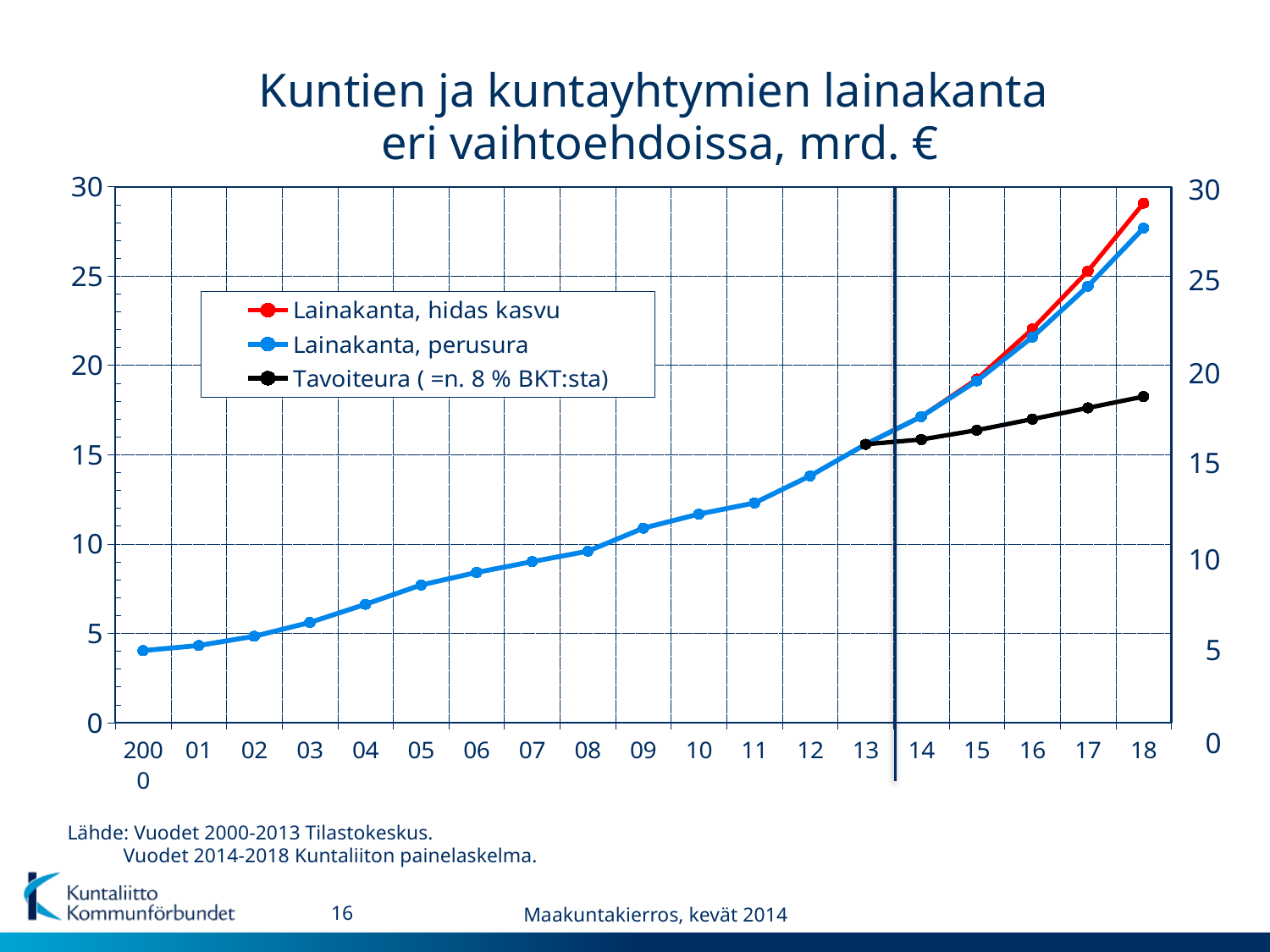
How many series does the legend list? 3 Does the 'Lainakanta, perusura' series rise or fall from 2000 to 2018? rise How many years are shown on the x axis? 19 Is the value for 'Lainakanta, hidas kasvu' in 2018 greater or less than 25? greater Is the value for 'Lainakanta, perusura' in 2000 greater or less than 5? less Is the value for 'Tavoiteura ( =n. 8 % BKT:sta)' in 2018 greater or less than 20? less What colour is the 'Tavoiteura ( =n. 8 % BKT:sta)' line? black In 2018, which is higher: 'Lainakanta, hidas kasvu' or 'Lainakanta, perusura'? Lainakanta, hidas kasvu What kind of chart is shown on the slide? line chart Which series has the lowest value in 2018? Tavoiteura ( =n. 8 % BKT:sta)